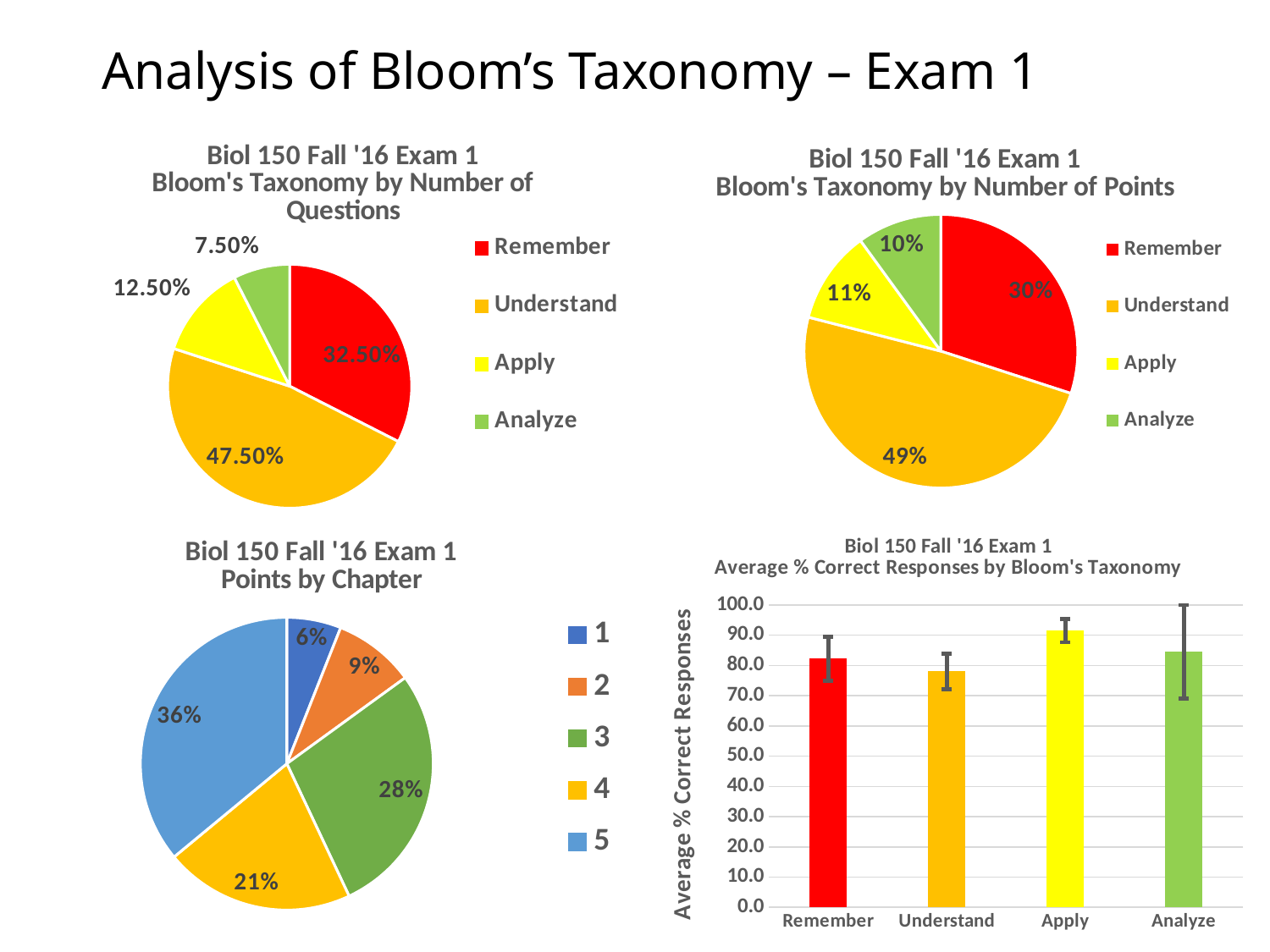
In the 'Average % Correct Responses by Bloom's Taxonomy' chart, which category has the highest average % correct? Apply In the 'Bloom's Taxonomy by Number of Points' pie chart, which category has the largest slice? Understand What kind of chart is 'Average % Correct Responses by Bloom's Taxonomy'? bar chart In the 'Points by Chapter' pie chart, which chapter has the largest share of points? 5 In the 'Bloom's Taxonomy by Number of Points' pie chart, which is larger, Apply or Analyze? Apply In the 'Average % Correct Responses by Bloom's Taxonomy' chart, is the value for Understand greater or less than 70.0? greater In the 'Bloom's Taxonomy by Number of Questions' pie chart, what is the difference between the Remember and Apply shares? 20.00% In the 'Points by Chapter' pie chart, how many chapters are shown? 5 In the 'Points by Chapter' pie chart, what share of points comes from chapter 3? 28% In the 'Bloom's Taxonomy by Number of Points' pie chart, what share of points is Remember? 30% In the 'Bloom's Taxonomy by Number of Questions' pie chart, which category has the smallest slice? Analyze In the 'Bloom's Taxonomy by Number of Questions' pie chart, what share of questions is Understand? 47.50%